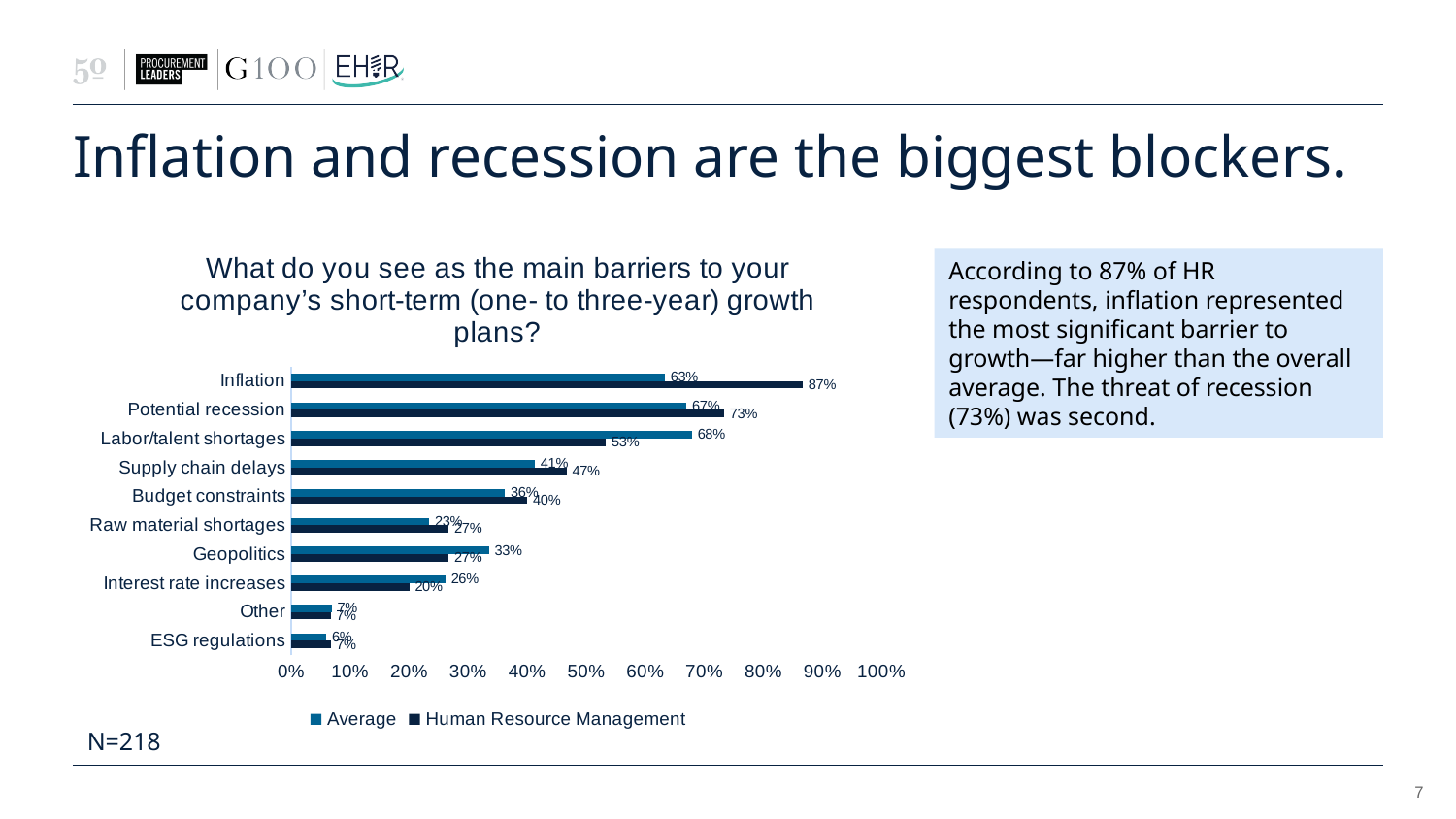
What is the Average value for Inflation? 63% How many series does the legend list? 2 What is the sample size (N) stated on the slide? N=218 Which category has the highest Human Resource Management value? Inflation What is the difference between the Human Resource Management and Average values for Inflation? 24% What is the Human Resource Management value for Inflation? 87% For Labor/talent shortages, which is larger: the Average value or the Human Resource Management value? Average Is the Human Resource Management value for Supply chain delays greater or less than 40%? greater What is the Human Resource Management value for Potential recession? 73% What is the Average value for Labor/talent shortages? 68% What kind of chart is shown on the slide? Bar chart How many barrier categories are plotted on the chart? 10